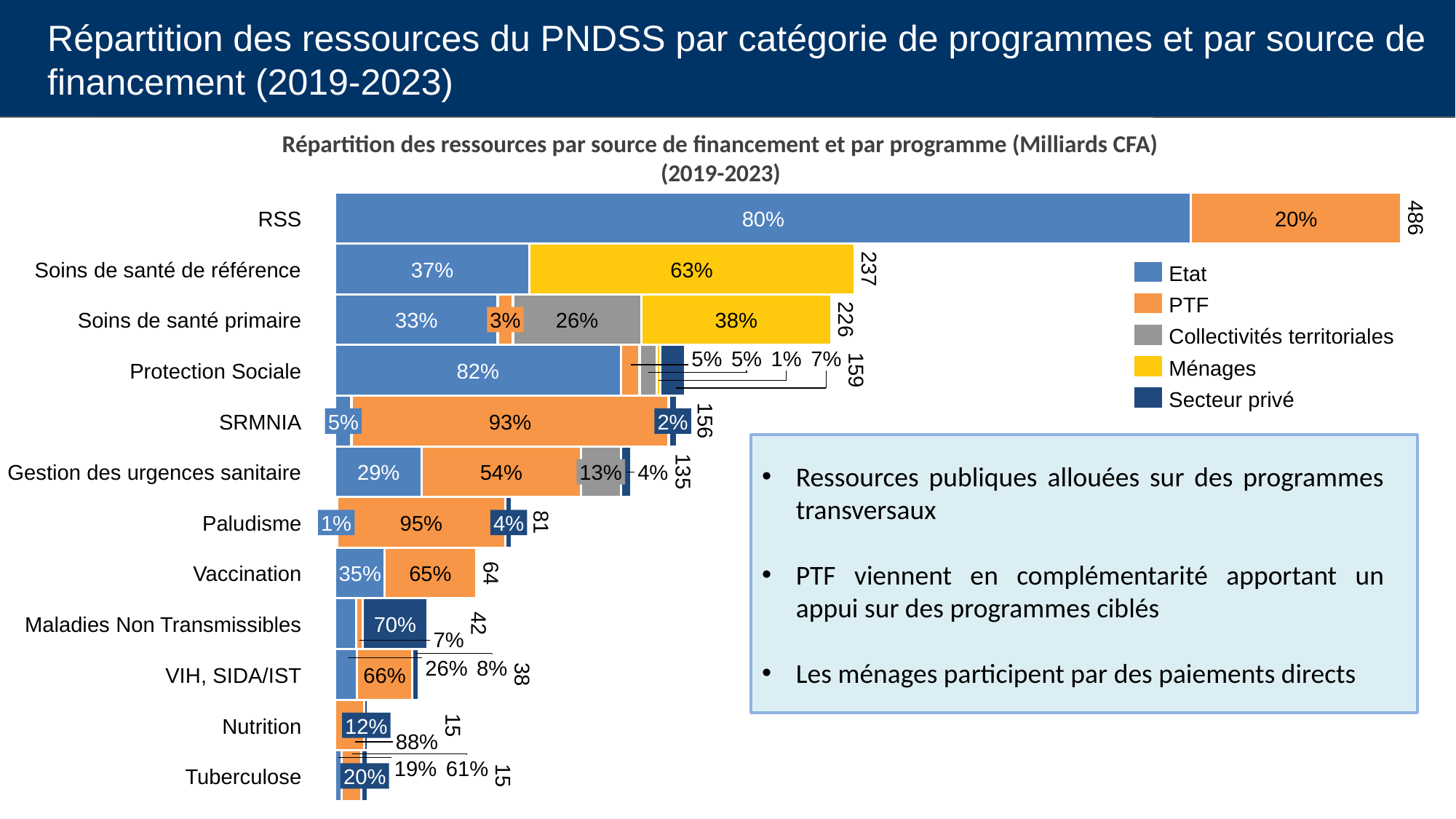
Which programme category has the highest total resources? RSS What share of the Soins de santé de référence resources comes from Ménages? 63% What share of the SRMNIA resources comes from PTF? 93% What kind of chart is shown on the slide? Stacked bar chart How many funding sources does the legend list? 5 What is the total (in Milliards CFA) shown for RSS? 486 What is the difference between the total for RSS and the total for Soins de santé de référence? 249 Which has a larger total, Paludisme or Vaccination? Paludisme What share of the Maladies Non Transmissibles resources comes from Secteur privé? 70% What is the total (in Milliards CFA) shown for Gestion des urgences sanitaire? 135 What share of the Soins de santé primaire resources comes from Collectivités territoriales? 26% How many programme categories are shown on the chart? 12